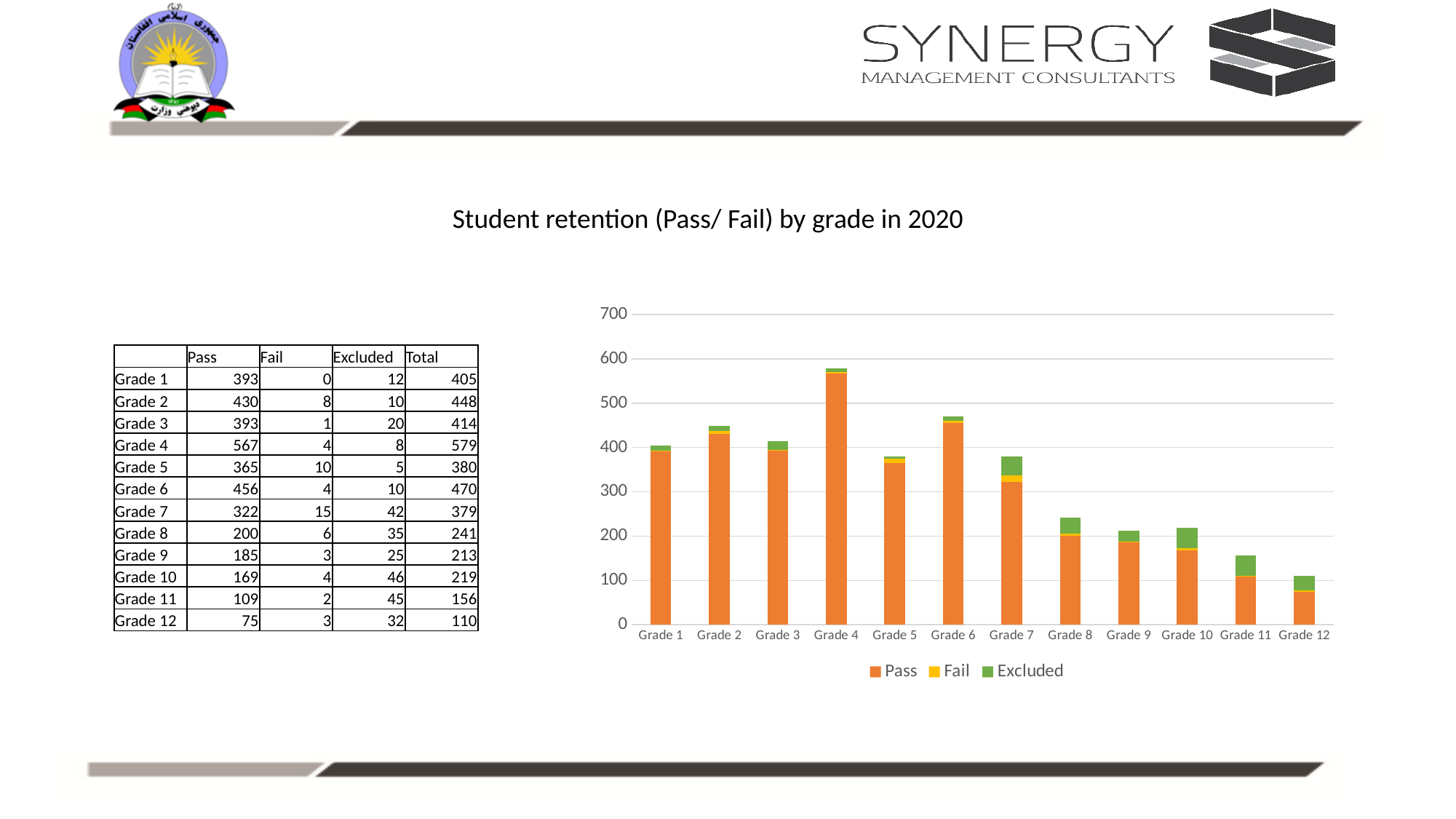
What is the Pass value for Grade 4? 567 How many grade categories are plotted on the x axis? 12 Is the total for Grade 8 greater or less than 300? less Which grade has the tallest stacked bar? Grade 4 Do the stacked bar totals generally rise or fall from Grade 7 to Grade 12? fall What is the total of the stacked bar for Grade 7? 379 What kind of chart is shown on the slide? stacked bar chart Which grade has the shortest stacked bar? Grade 12 What is the difference between the Pass values for Grade 2 and Grade 5? 65 How many series does the chart legend list? 3 What is the Excluded value for Grade 10? 46 Which is larger, the total for Grade 6 or the total for Grade 3? Grade 6